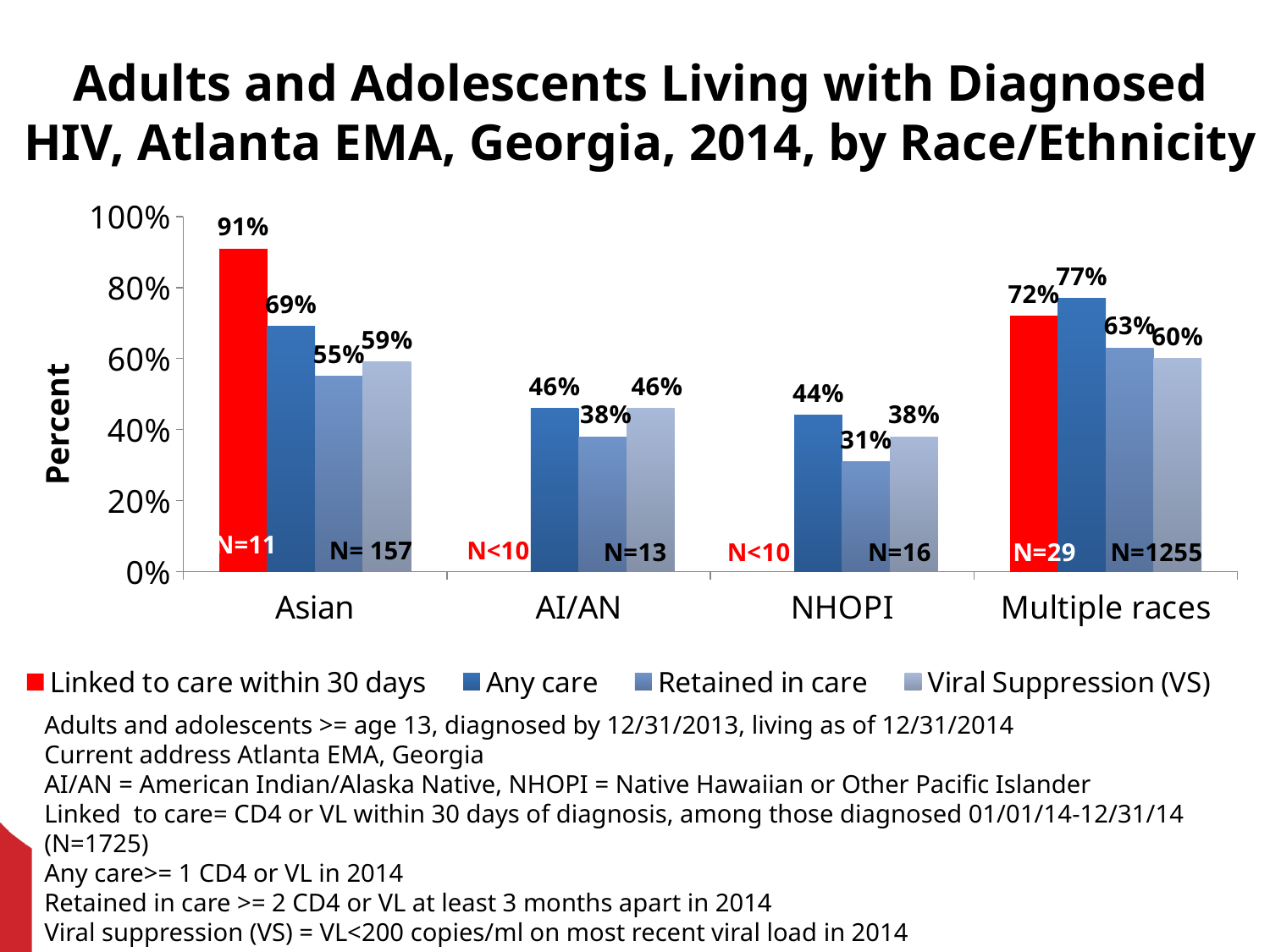
How many series does the legend list? 4 What is the Viral Suppression (VS) value for the Multiple races group? 60% What is the difference between the Any care and Retained in care percentages for the Asian group? 14% What is the Retained in care value for NHOPI? 31% Which race/ethnicity group has the lowest Retained in care percentage? NHOPI What percentage of Asian adults and adolescents were linked to care within 30 days? 91% Which race/ethnicity group has the highest Any care percentage? Multiple races What kind of chart is shown on the slide? Bar chart Which is larger for the Multiple races group: Linked to care within 30 days or Any care? Any care How many race/ethnicity categories are shown on the x axis? 4 Which series is shown in red in the legend? Linked to care within 30 days What is the Any care value for AI/AN? 46%